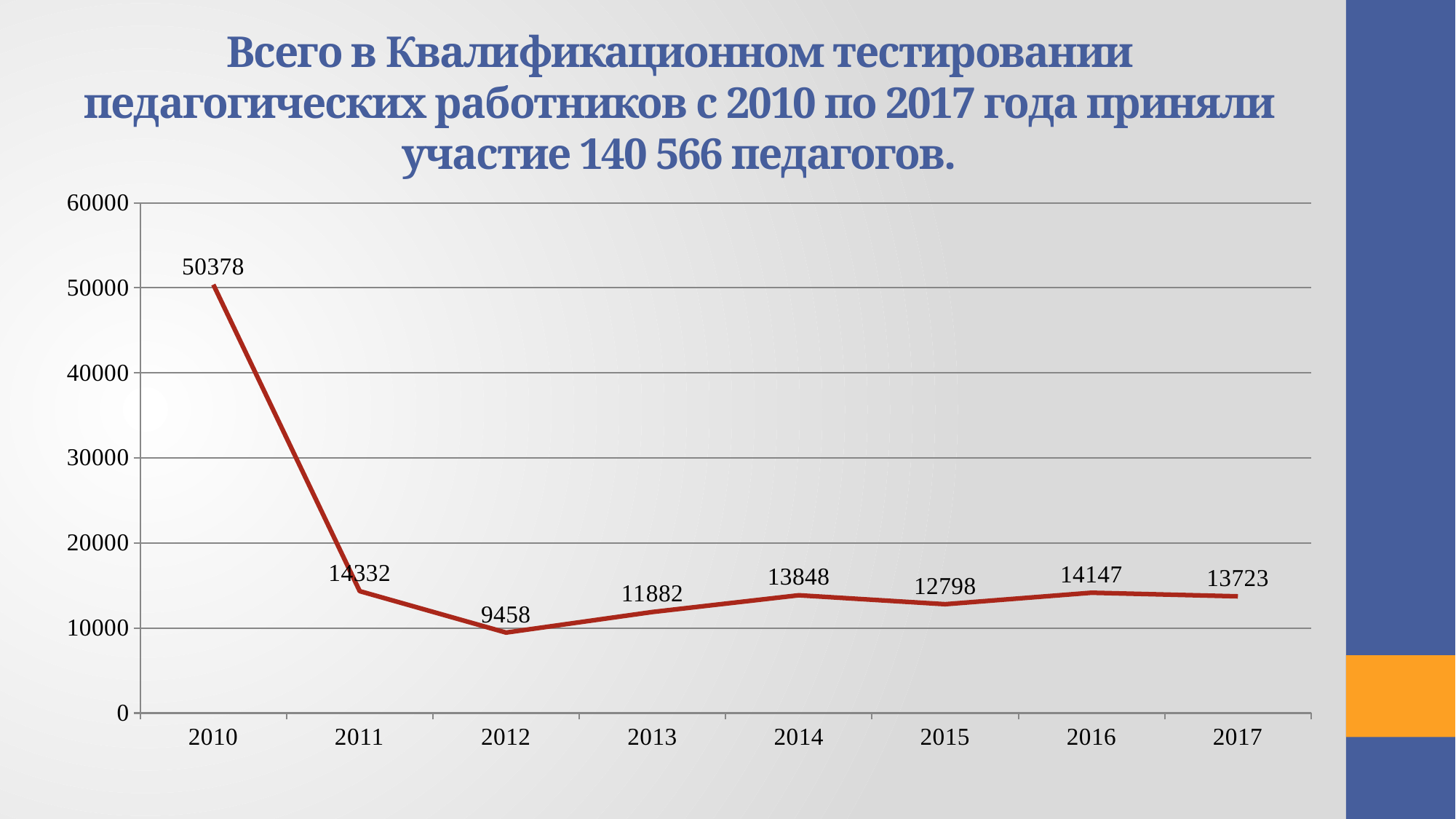
Which year has the highest value? 2010 What kind of chart is shown on the slide? line chart What is the value for 2010? 50378 What is the value for 2015? 12798 Which is larger, the value for 2014 or the value for 2013? 2014 What is the difference between the values for 2010 and 2011? 36046 What is the value for 2012? 9458 Which year has the lowest value? 2012 What is the difference between the values for 2016 and 2015? 1349 How many years are plotted on the x axis? 8 Is the value for 2011 greater or less than 20000? less What is the value for 2017? 13723